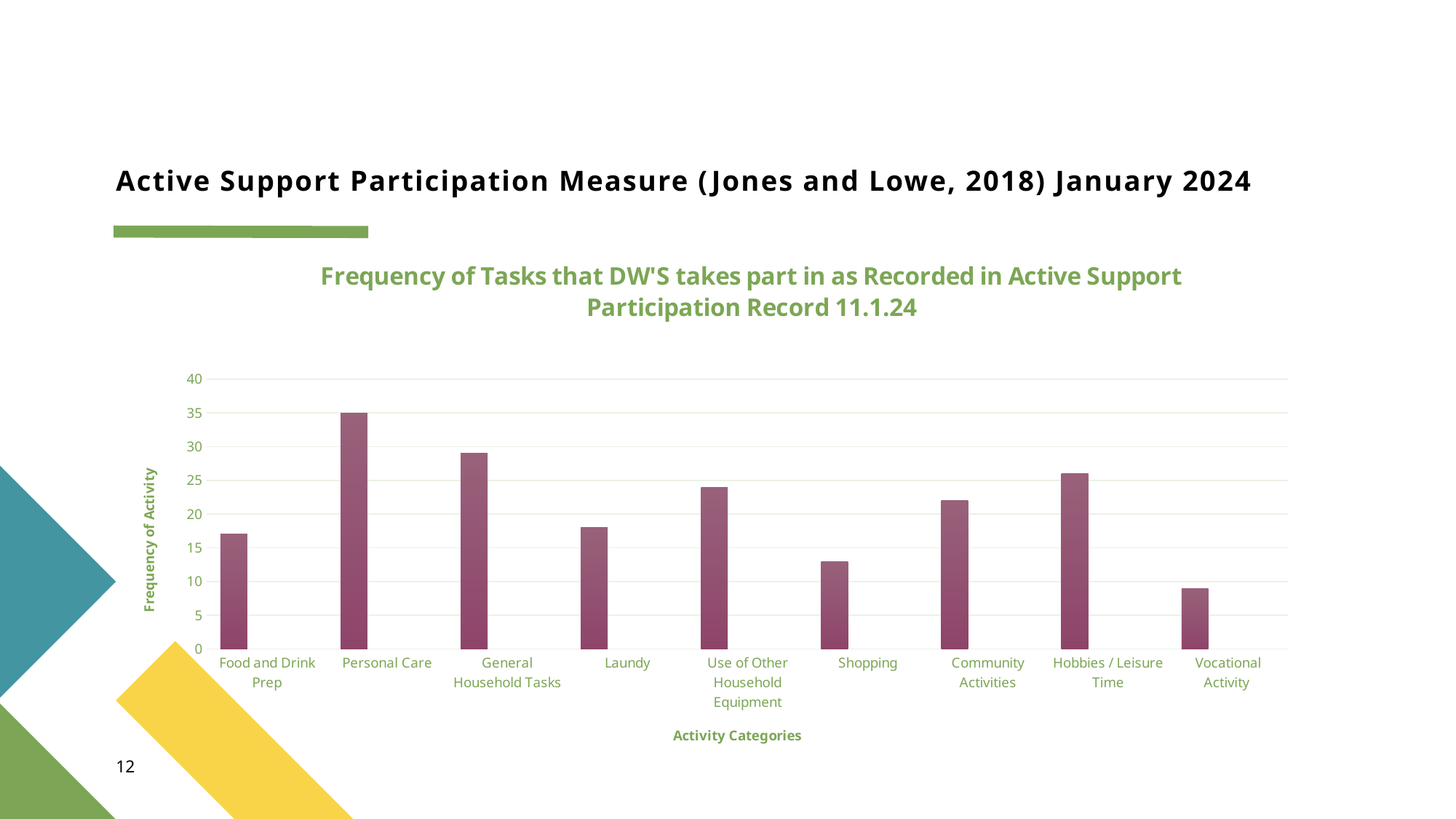
Is the value for General Household Tasks greater or less than 25? greater Which activity category has the highest frequency of activity? Personal Care Is the value for Shopping greater or less than 10? greater Which is larger, the value for Shopping or the value for Community Activities? Community Activities How many activity categories are plotted in the chart? 9 Is the value for Vocational Activity greater or less than 10? less What is the frequency of activity for Personal Care? 35 Which is larger, the value for Personal Care or the value for General Household Tasks? Personal Care What type of chart is shown on the slide? bar chart Which activity category has the lowest frequency of activity? Vocational Activity What is the title of the vertical axis of the chart? Frequency of Activity